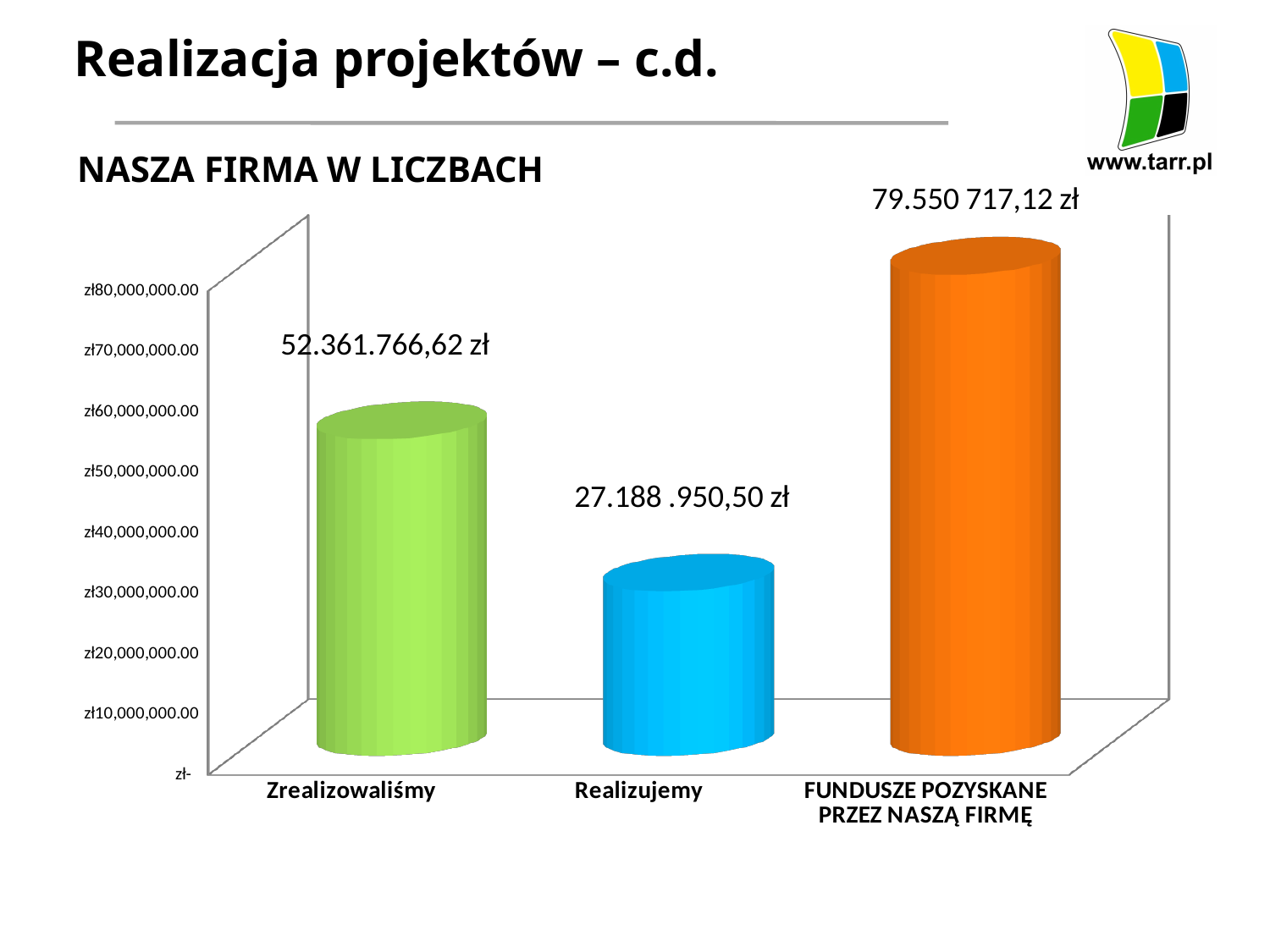
How many categories are shown on the chart? 3 What is the value for FUNDUSZE POZYSKANE PRZEZ NASZĄ FIRMĘ? 79.550 717,12 zł Which category has the highest value? FUNDUSZE POZYSKANE PRZEZ NASZĄ FIRMĘ Is the value for Realizujemy greater or less than zł40,000,000.00? less What is the value for Zrealizowaliśmy? 52.361.766,62 zł Which is larger, the value for Zrealizowaliśmy or the value for Realizujemy? Zrealizowaliśmy What is the value for Realizujemy? 27.188 .950,50 zł What is the difference between the values for FUNDUSZE POZYSKANE PRZEZ NASZĄ FIRMĘ and Zrealizowaliśmy? 27.188.950,50 zł Which category has the lowest value? Realizujemy What is the difference between the values for Zrealizowaliśmy and Realizujemy? 25.172.816,12 zł What kind of chart is shown on the slide? bar chart Is the value for FUNDUSZE POZYSKANE PRZEZ NASZĄ FIRMĘ greater or less than zł70,000,000.00? greater